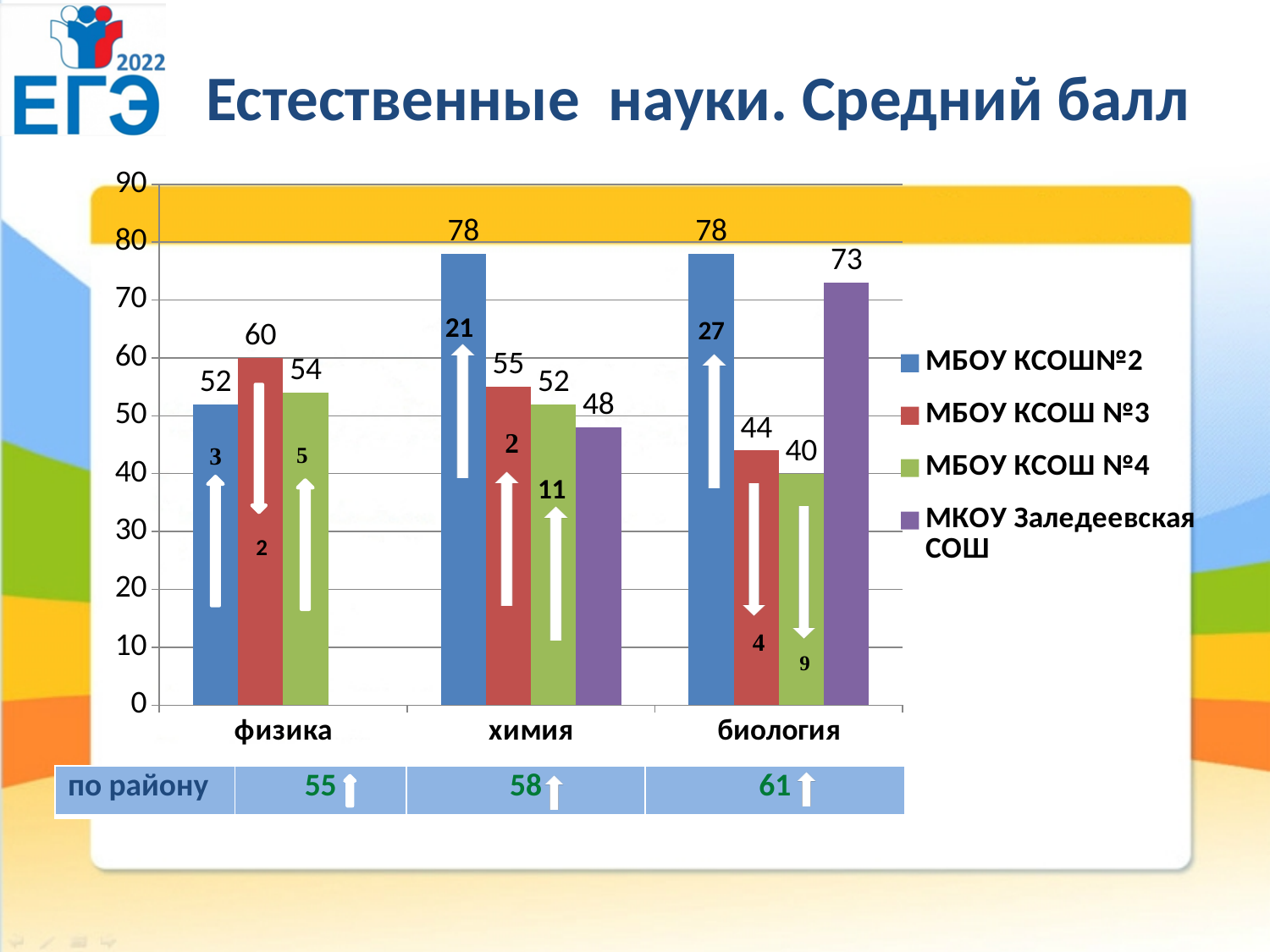
What is the value for МБОУ КСОШ №4 in химия? 52 Which is larger: МБОУ КСОШ №4 in физика or МБОУ КСОШ №4 in биология? МБОУ КСОШ №4 in физика What is the difference between МБОУ КСОШ№2 and МБОУ КСОШ №3 in биология? 34 How many series does the legend list? 4 How many subject categories are shown on the x axis? 3 What is the value for МКОУ Заледеевская СОШ in биология? 73 Which school has the highest value in химия? МБОУ КСОШ№2 Which school has the lowest value in биология? МБОУ КСОШ №4 Is the value for МКОУ Заледеевская СОШ in химия greater or less than 50? less What is the title of the chart? Естественные науки. Средний балл What is the value for МБОУ КСОШ №3 in физика? 60 What kind of chart is shown on the slide? bar chart